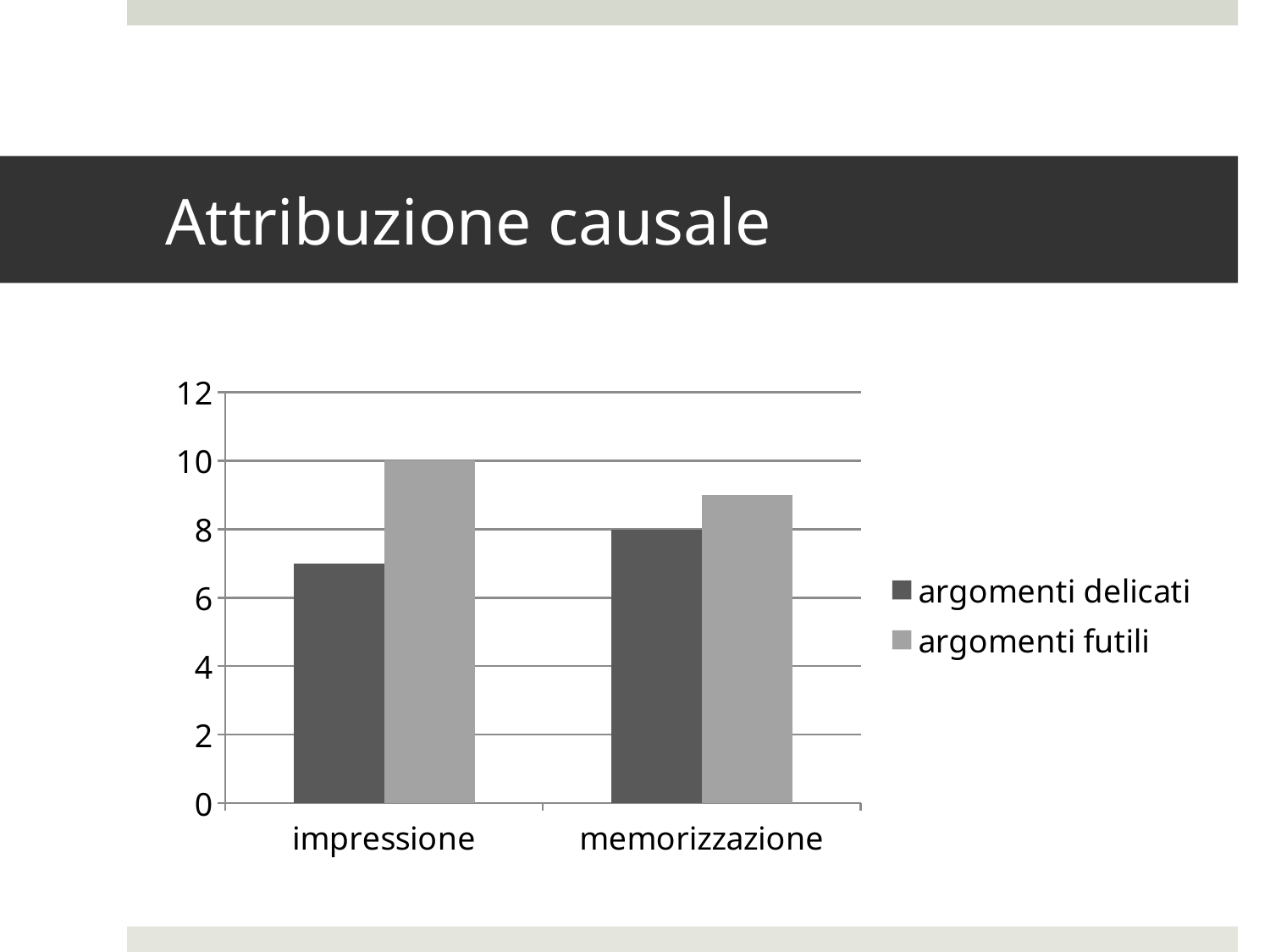
Which bar is the lowest in the chart? argomenti delicati for impressione In the memorizzazione category, which series has the larger value? argomenti futili Which bar is the highest in the chart? argomenti futili for impressione What kind of chart is shown on the slide? bar chart What is the value for argomenti futili in the impressione category? 10 In the impressione category, which series has the larger value? argomenti futili Does the value for argomenti delicati rise or fall from impressione to memorizzazione? rise Is the value for argomenti futili in the memorizzazione category greater or less than 10? less How many categories are shown on the x axis? 2 Is the value for argomenti delicati in the impressione category greater or less than 8? less What is the value for argomenti delicati in the memorizzazione category? 8 How many series does the legend list? 2